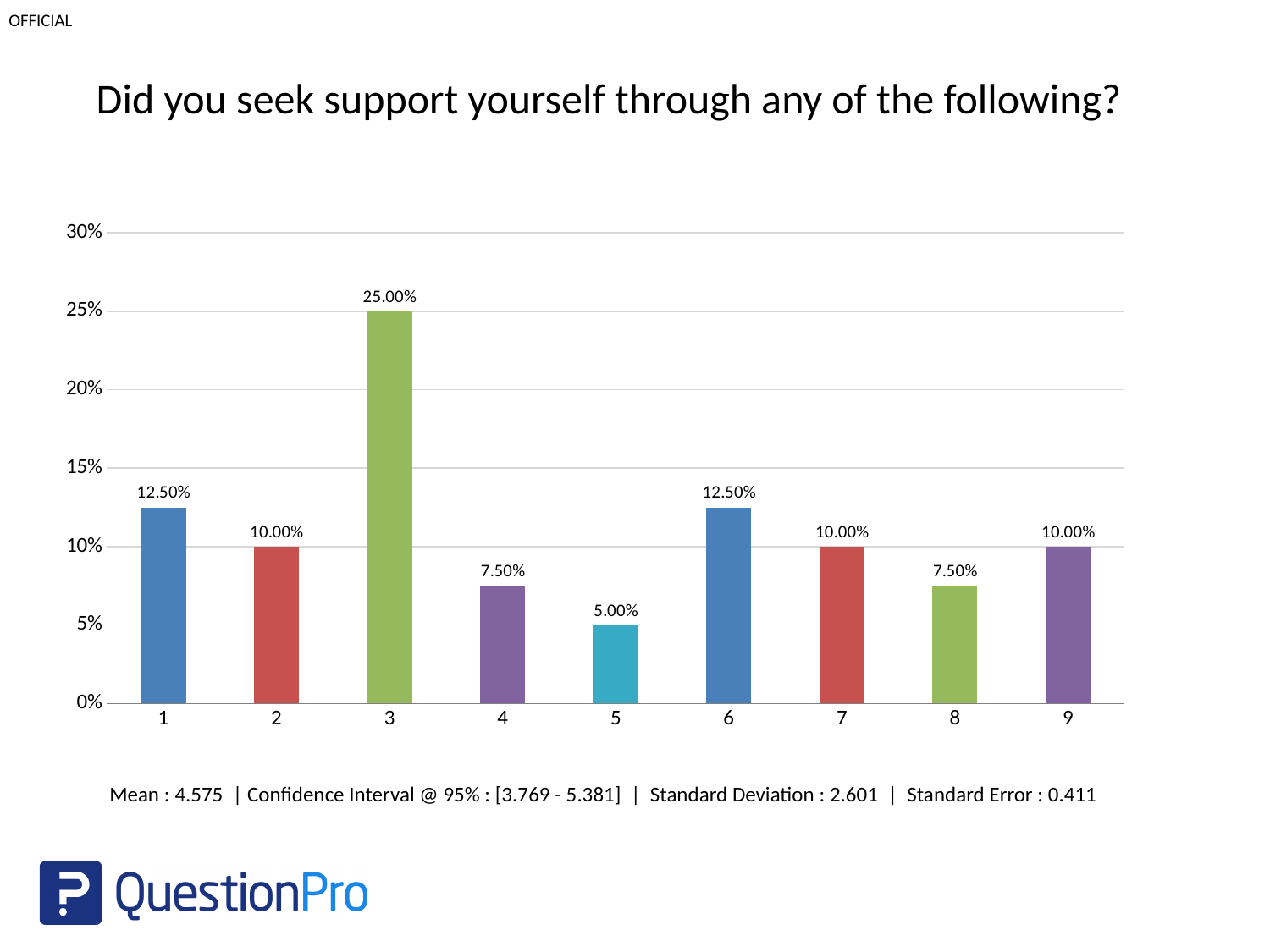
What is the value for category 3? 25.00% What is the value for category 5? 5.00% What is the title of the chart? Did you seek support yourself through any of the following? Which is larger, the value for category 4 or the value for category 7? 7 What is the difference between the values for category 3 and category 1? 12.50% Is the value for category 3 greater or less than 20%? greater What is the mean reported below the chart? 4.575 What is the value for category 8? 7.50% Which category has the lowest value? 5 How many categories are shown on the x axis? 9 Which category has the highest value? 3 What kind of chart is shown on the slide? bar chart